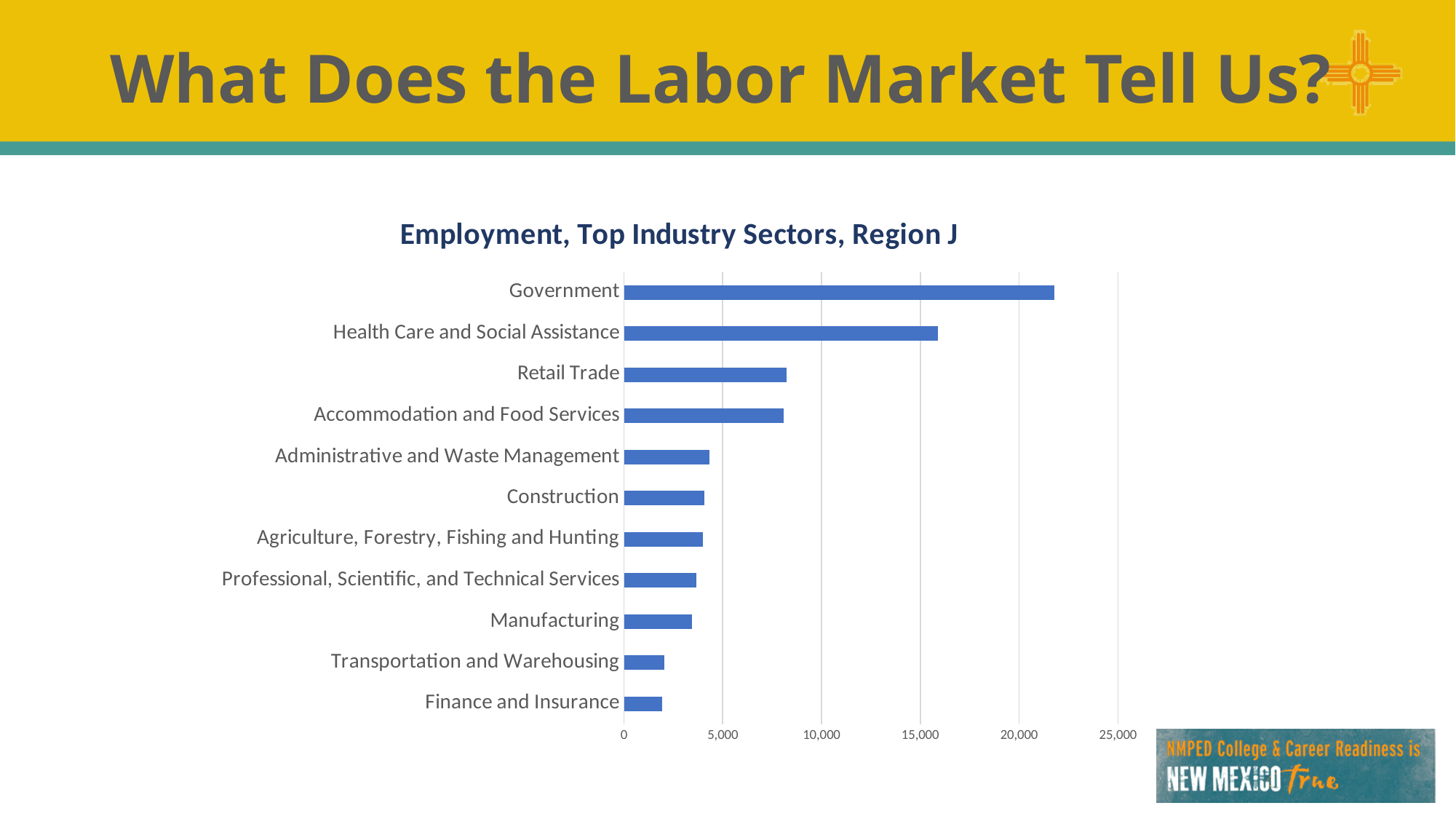
Which has higher employment, Retail Trade or Manufacturing? Retail Trade Which industry sector has the highest employment? Government What is the title of the chart? Employment, Top Industry Sectors, Region J Which industry sector has the lowest employment? Finance and Insurance What kind of chart is shown on the slide? bar chart Which has higher employment, Government or Health Care and Social Assistance? Government Is the value for Health Care and Social Assistance greater or less than 15,000? greater Is the value for Construction greater or less than 5,000? less Is the value for Government greater or less than 20,000? greater Do the employment values increase or decrease going from the top bar to the bottom bar? decrease How many industry sectors are shown in the chart? 11